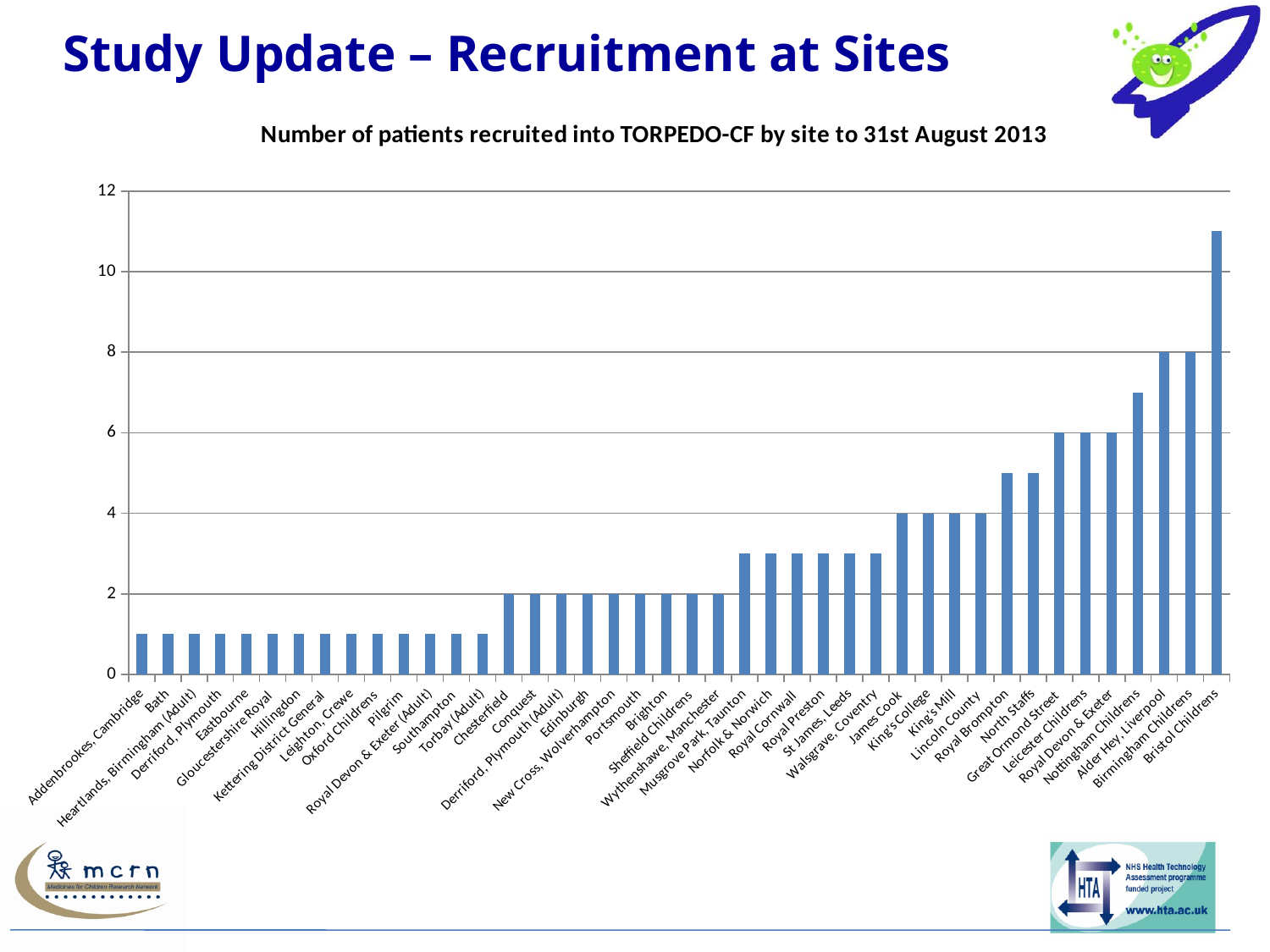
What kind of chart is shown on the slide? Bar chart What is the title of the chart? Number of patients recruited into TORPEDO-CF by site to 31st August 2013 Do the values generally rise or fall moving from left to right along the x axis? Rise Which site recruited more patients, James Cook or Chesterfield? James Cook How many patients were recruited at Alder Hey, Liverpool? 8 Which site recruited the most patients? Bristol Childrens How many patients were recruited at Great Ormond Street? 6 How many sites recruited exactly 8 patients? 2